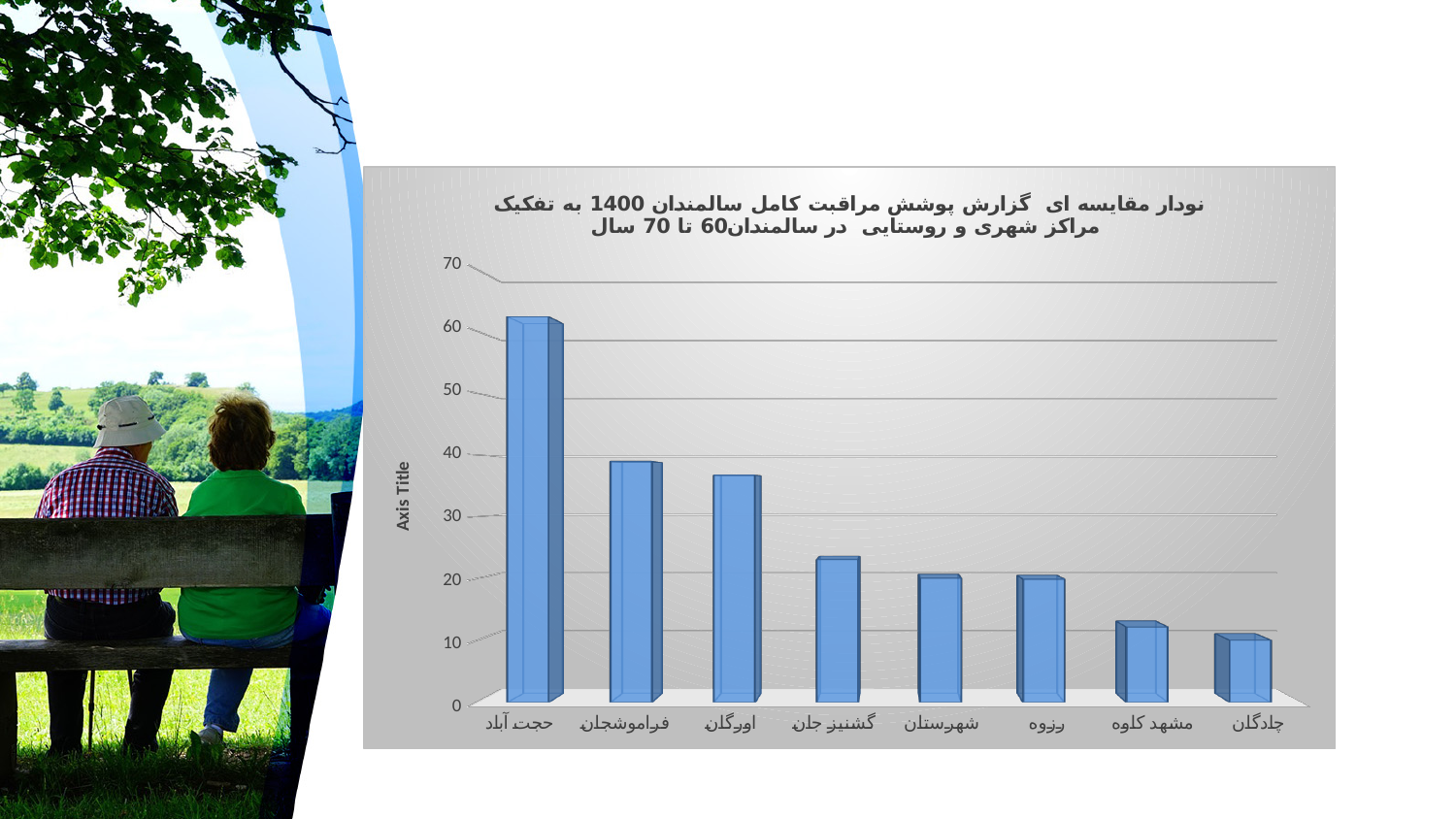
Is the value for فراموشجان greater or less than 30? greater Is the value for گشنیزجان greater or less than 30? less How many categories are shown on the x axis of the chart? 8 What is the label shown on the vertical axis of the chart? Axis Title Which is larger, the value for فراموشجان or the value for گشنیزجان? فراموشجان Which category has the highest bar in the chart? حجت آباد Which category has the lowest bar in the chart? چادگان Is the value for حجت آباد greater or less than 50? greater Do the bar values rise or fall moving from left to right along the x axis? Fall What kind of chart is shown on the slide? Bar chart